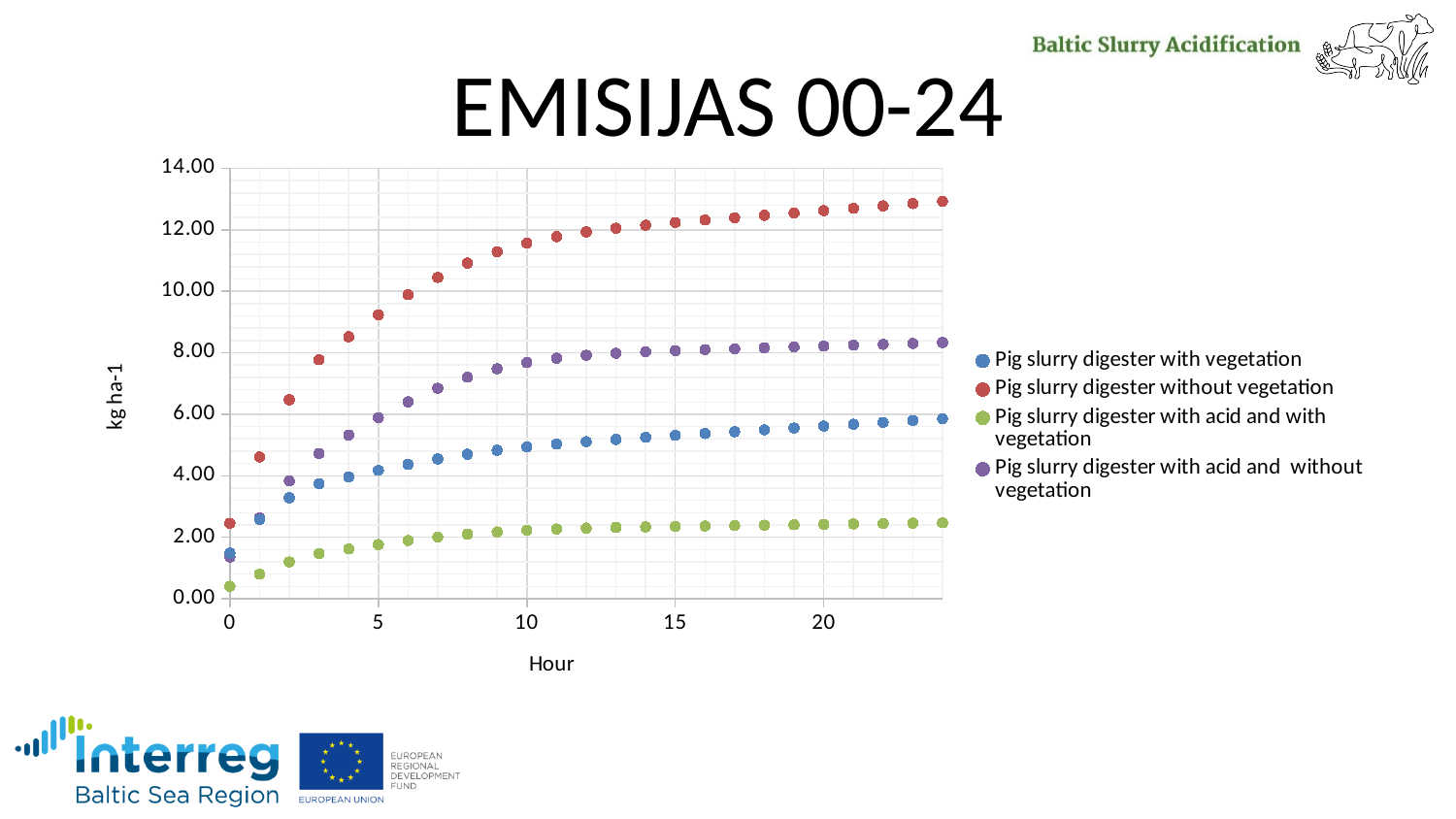
Is the value for Pig slurry digester with acid and without vegetation at hour 24 greater or less than 6.00? greater How many series does the legend list? 4 Which series has the highest values at hour 24? Pig slurry digester without vegetation Is the value for Pig slurry digester without vegetation at hour 24 greater or less than 12.00? greater What is the label of the x axis? Hour Which series has the lowest values at hour 24? Pig slurry digester with acid and with vegetation At hour 10, which is larger: the value for Pig slurry digester with vegetation or the value for Pig slurry digester with acid and without vegetation? Pig slurry digester with acid and without vegetation Is the value for Pig slurry digester with acid and with vegetation at hour 24 greater or less than 4.00? less What kind of chart is shown on the slide? scatter chart Do the values for Pig slurry digester without vegetation rise or fall as the hour increases? rise What is the title of the chart? EMISIJAS 00-24